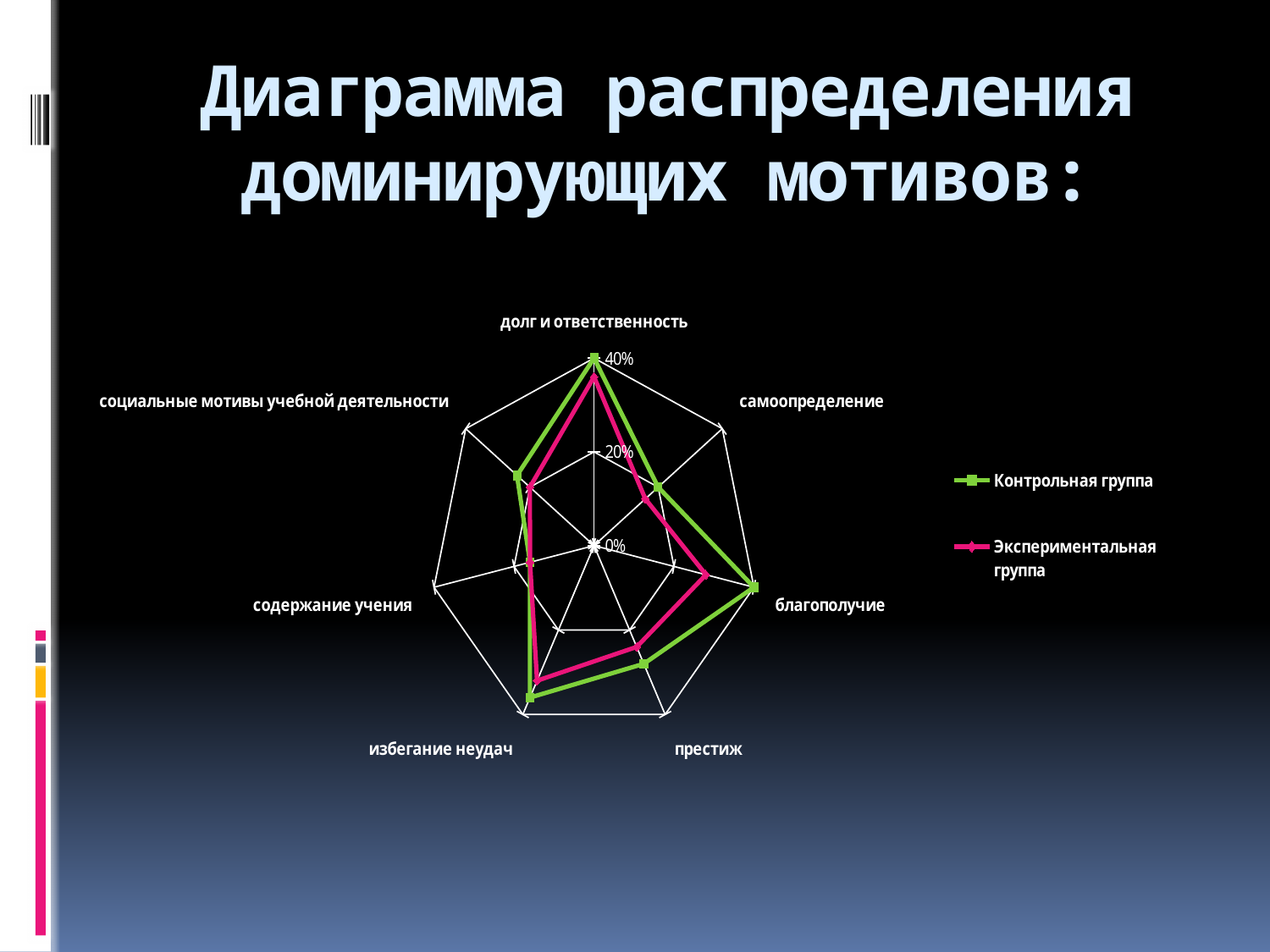
Is the value for Контрольная группа on the избегание неудач axis greater or less than 20%? greater What is the highest percentage tick shown on the chart's axis? 40% Which category has the lowest value for Контрольная группа? содержание учения What kind of chart is shown on the slide? Radar chart How many series does the legend list? 2 On the благополучие axis, which series has the larger value, Контрольная группа or Экспериментальная группа? Контрольная группа Is the value for Контрольная группа on the содержание учения axis greater or less than 20%? less What is the value for Контрольная группа on the долг и ответственность axis? 40% How many categories (axes) does the radar chart have? 7 Which colour represents Экспериментальная группа in the chart? Pink Is the value for Экспериментальная группа on the благополучие axis greater or less than 20%? greater On the престиж axis, which series has the larger value, Контрольная группа or Экспериментальная группа? Контрольная группа